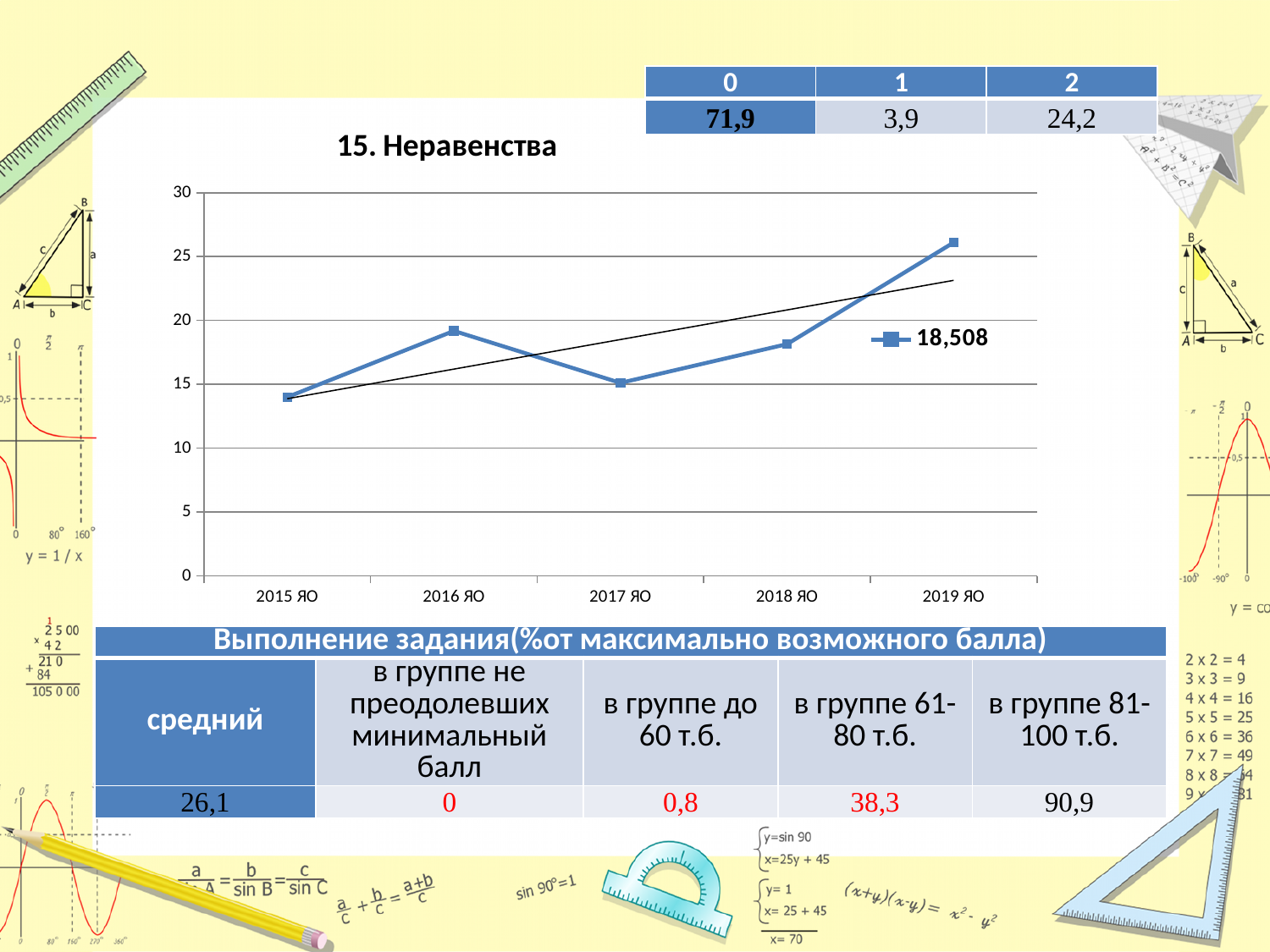
What is the title of the chart? 15. Неравенства Which year has the lowest value on the chart? 2015 ЯО What kind of chart is shown on the slide? line chart Is the value for 2019 ЯО greater or less than 25? greater Overall, do the values rise or fall from 2015 ЯО to 2019 ЯО? rise Which is larger, the value for 2016 ЯО or the value for 2017 ЯО? 2016 ЯО Is the value for 2015 ЯО greater or less than 15? less How many series does the chart legend list? 1 Which year has the highest value on the chart? 2019 ЯО Is the value for 2018 ЯО greater or less than 20? less What is the legend entry shown on the chart? 18,508 How many points are plotted along the x axis of the chart? 5